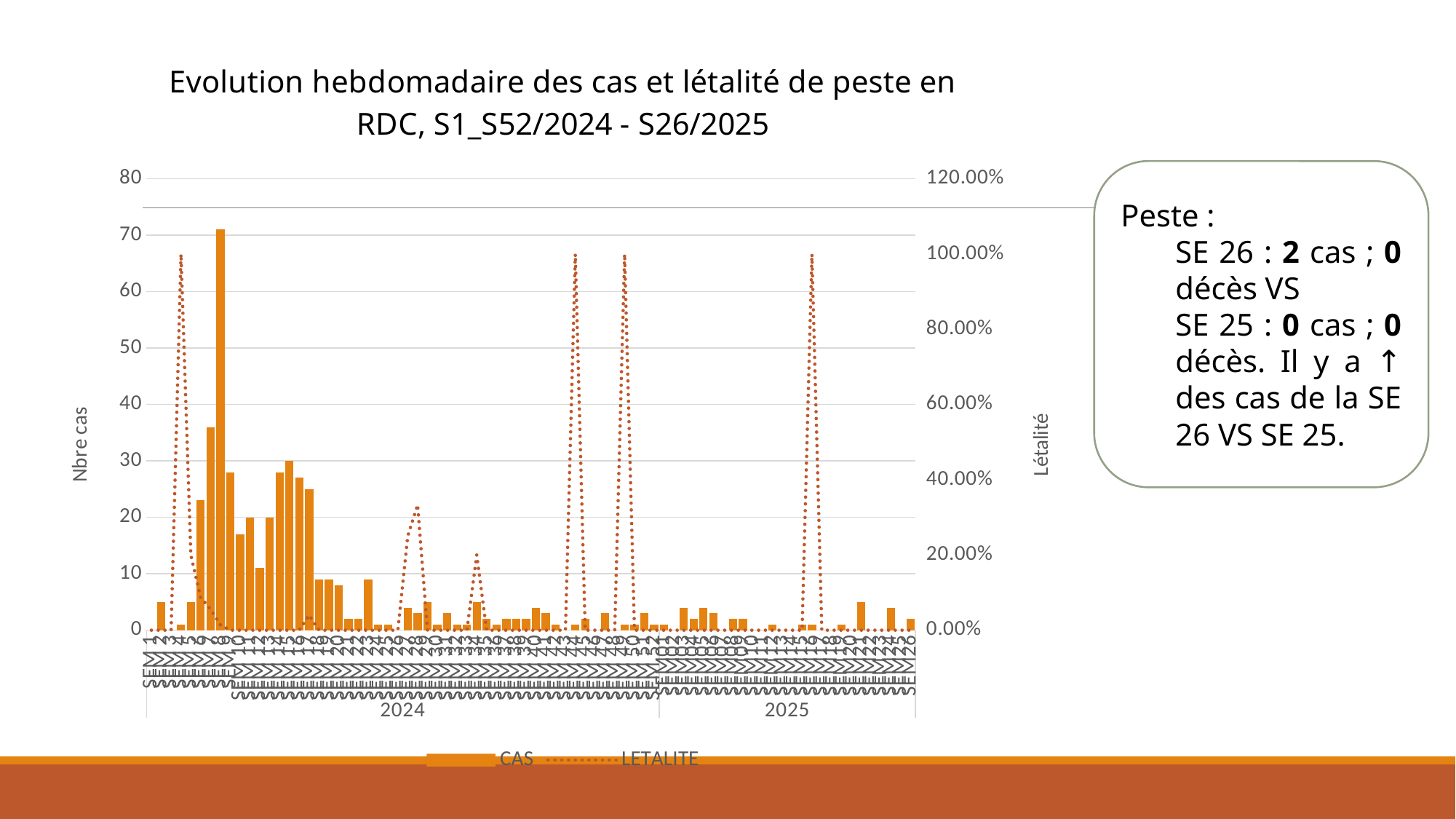
Is the tallest CAS bar greater or less than 80? less Which year section contains the tallest CAS bar, 2024 or 2025? 2024 Is the value of the tallest CAS bar greater or less than 60? greater What is the title of the chart? Evolution hebdomadaire des cas et létalité de peste en RDC, S1_S52/2024 - S26/2025 Do the CAS bars generally rise or fall from the start of 2024 to 2025? fall How many year groups are labelled on the x axis? 2 Is the highest point of the LETALITE line greater or less than 80.00%? greater Which year section shows higher CAS bars overall, 2024 or 2025? 2024 What kind of chart is shown on the slide? A bar chart combined with a dotted line How many series does the legend list? 2 What are the two series named in the legend? CAS and LETALITE